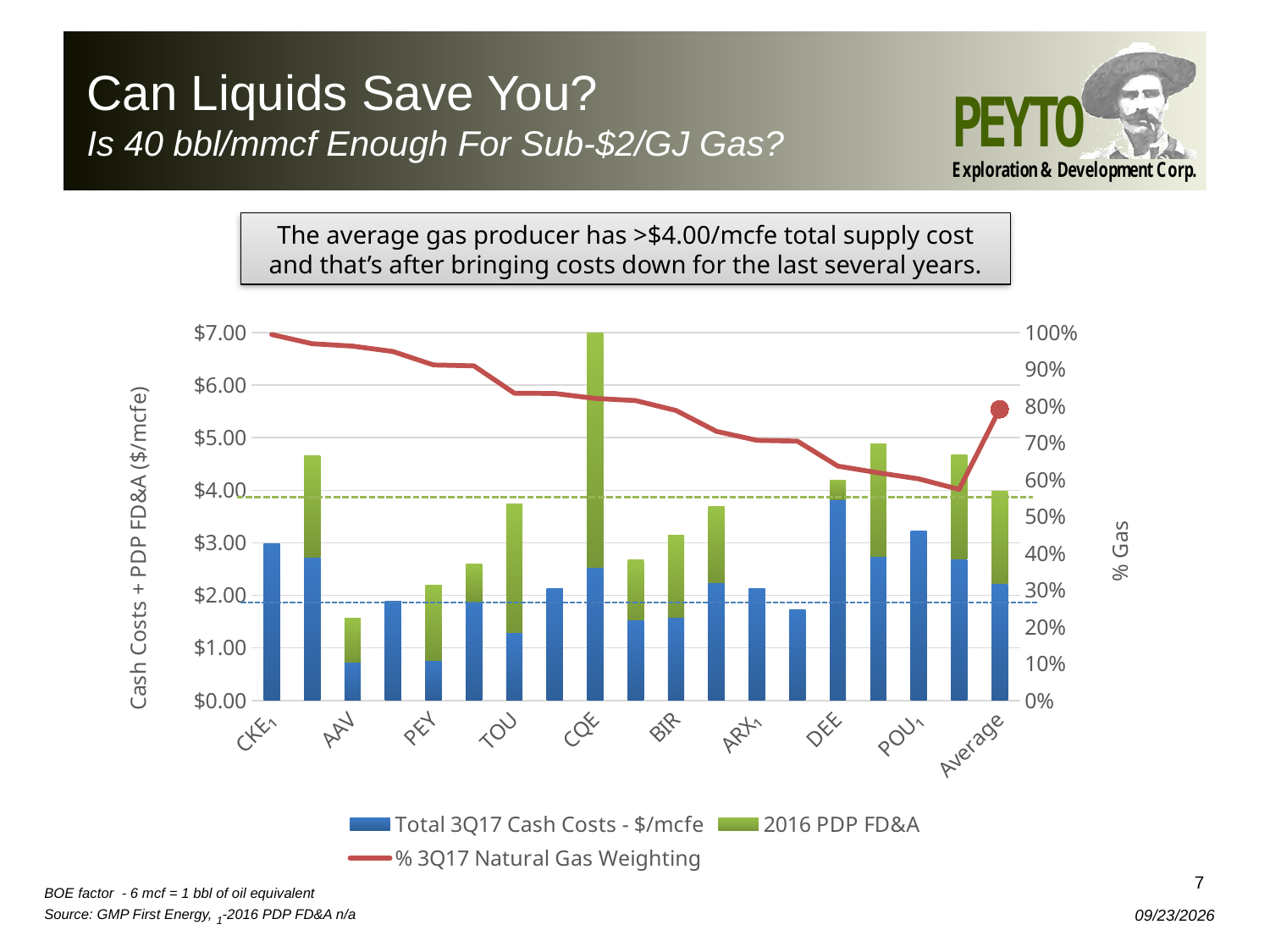
Is the total stacked bar value for TOU greater or less than $4.00? less Is the % 3Q17 Natural Gas Weighting value for CKE1 greater or less than 90%? greater Which labelled category has the tallest stacked bar (Cash Costs + PDP FD&A)? CQE Which has the higher % 3Q17 Natural Gas Weighting, CKE1 or DEE? CKE1 Is the total stacked bar value for AAV greater or less than $2.00? less What is the title of the right-hand vertical axis? % Gas Which has the larger total stacked bar, CQE or AAV? CQE What kind of chart is shown on the slide? A combination bar and line chart (stacked bars with a line) Does the % 3Q17 Natural Gas Weighting line generally rise or fall from CKE1 to POU1? fall How many series does the chart legend list? 3